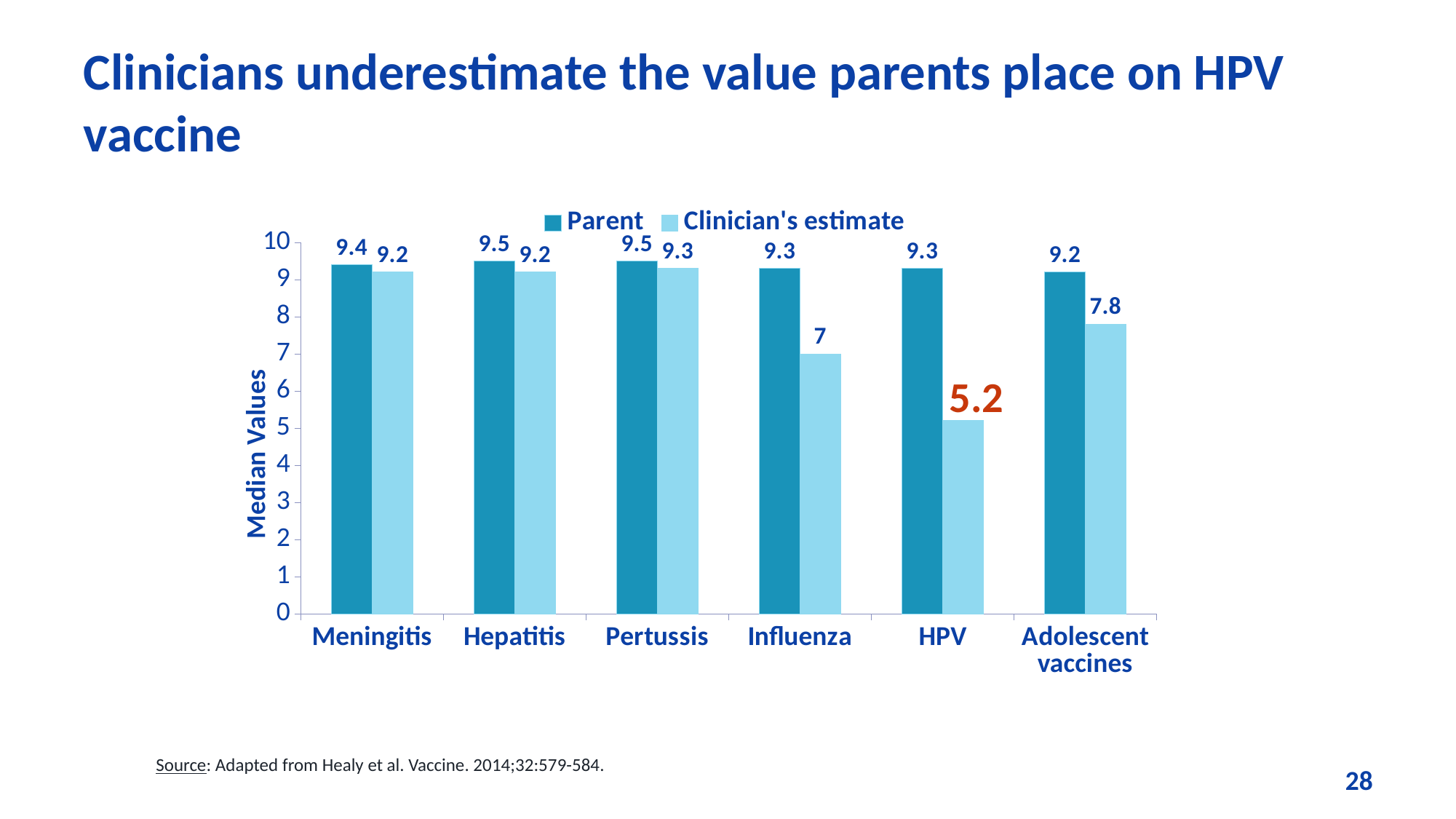
What is the difference between the Parent value and the Clinician's estimate value for HPV? 4.1 What kind of chart is shown on the slide? Bar chart How many categories are shown on the x axis? 6 How many series does the legend list? 2 What is the Clinician's estimate value for HPV? 5.2 What is the Parent value for Meningitis? 9.4 What is the Clinician's estimate value for Adolescent vaccines? 7.8 What is the difference between the Parent value and the Clinician's estimate value for Influenza? 2.3 Which category has the lowest Clinician's estimate value? HPV Which category has the lowest Parent value? Adolescent vaccines What is the Parent value for Pertussis? 9.5 Which is larger for Influenza, the Parent value or the Clinician's estimate value? Parent